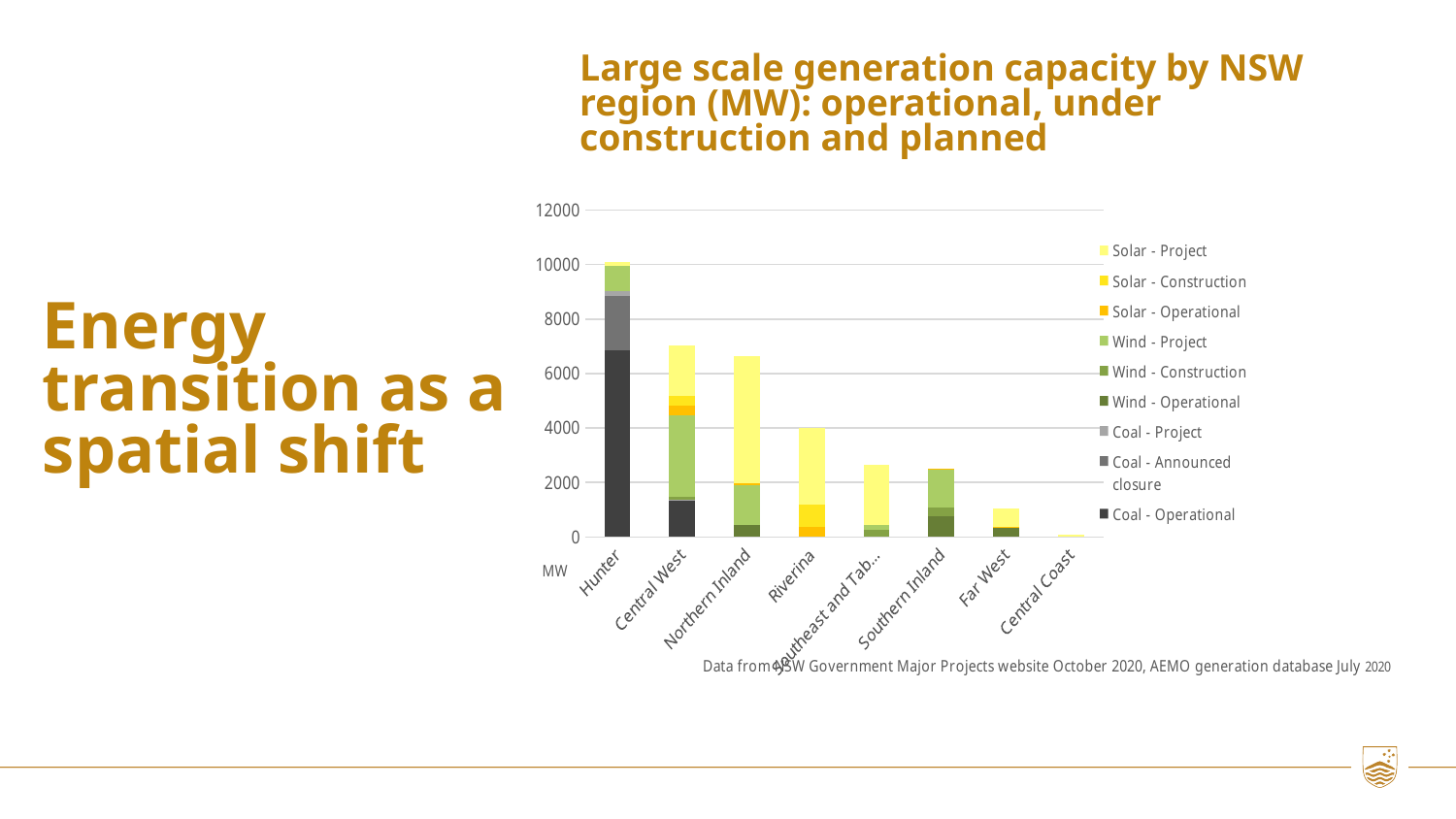
Is the total value for Riverina greater or less than 6000? less Do the total bar heights generally rise or fall moving from left to right along the x axis? Fall Which region has the highest total generation capacity in the chart? Hunter Which series in the legend is shown in black? Coal - Operational Which has a larger total generation capacity, Central West or Riverina? Central West How many NSW regions are shown on the x axis of the chart? 8 Is the total value for Central West greater or less than 6000? greater Is the total value for Hunter greater or less than 8000? greater How many series does the chart's legend list? 9 What kind of chart is shown on the slide? Stacked bar chart Which region has the lowest total generation capacity in the chart? Central Coast